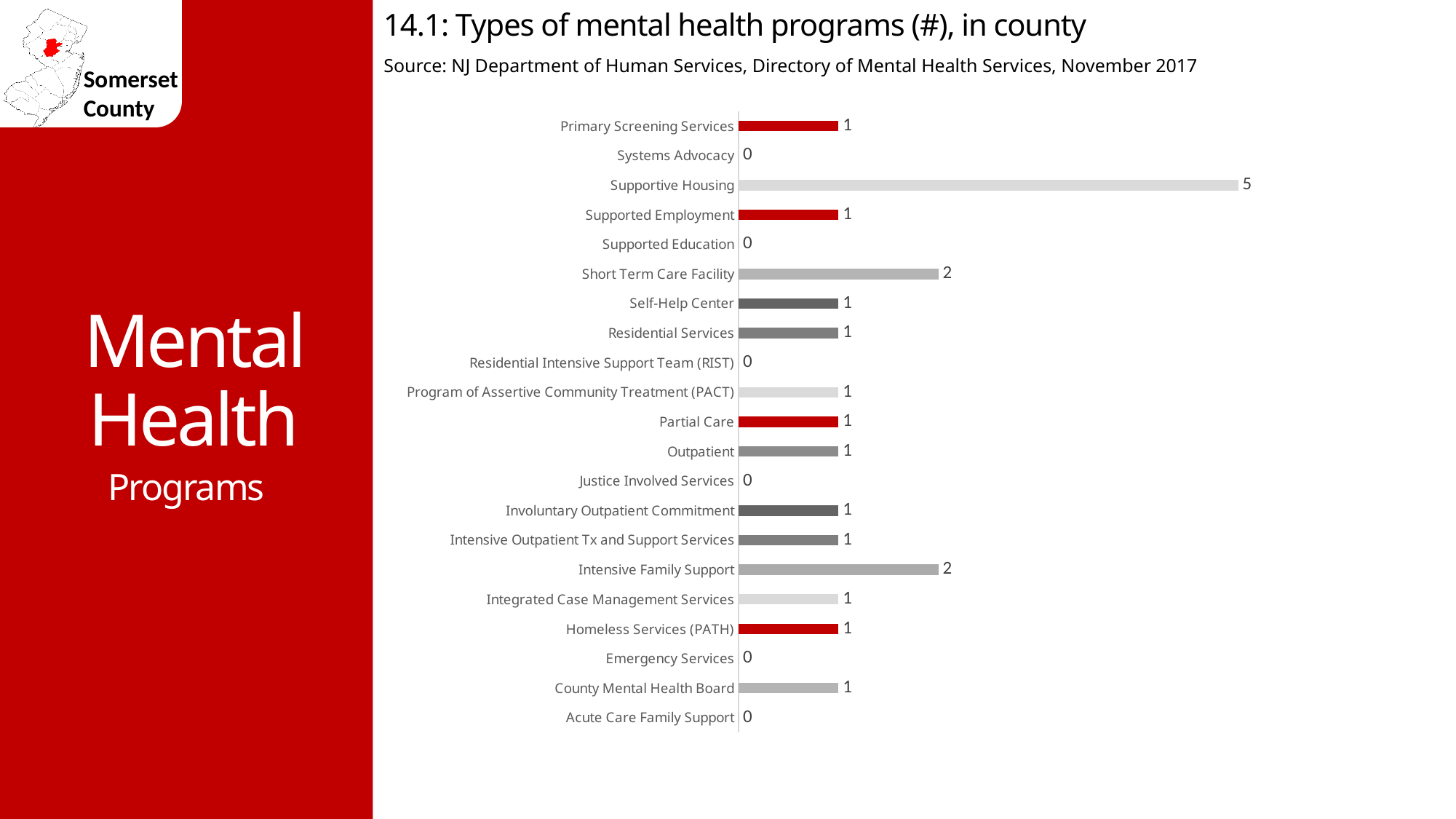
How many Supportive Housing programs are shown? 5 What is the value for Systems Advocacy? 0 What type of chart is shown on the slide? bar chart Which is larger, Intensive Family Support or Outpatient? Intensive Family Support What is the value for Homeless Services (PATH)? 1 What is the value for Short Term Care Facility? 2 Which program type has the highest number of programs? Supportive Housing What is the source cited for the chart? NJ Department of Human Services, Directory of Mental Health Services, November 2017 How many program types have a value of 0? 6 What is the difference between Supportive Housing and Short Term Care Facility? 3 How many program types are listed on the chart? 21 What is the value for Intensive Family Support? 2